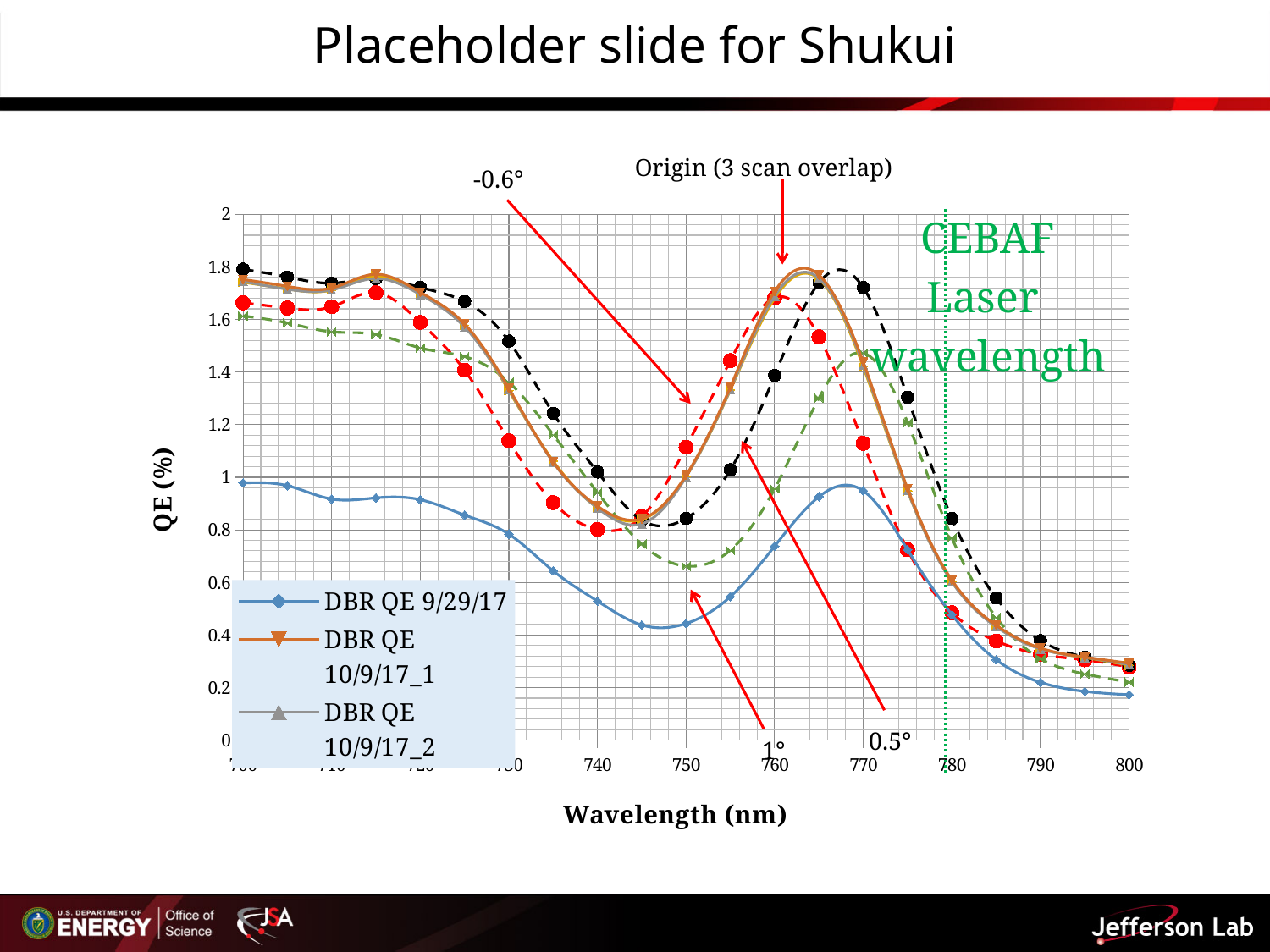
What is the y-axis title of the chart? QE (%) Is the value of DBR QE 10/9/17_1 at 800 nm greater or less than 0.4? less What is the x-axis title of the chart? Wavelength (nm) Is the value of DBR QE 9/29/17 at 800 nm greater or less than 0.2? less Does the DBR QE 9/29/17 series rise or fall between 780 nm and 800 nm? fall How many series does the visible legend list? 3 Is the value of DBR QE 9/29/17 at 700 nm greater or less than 0.8? greater What kind of chart is shown on the slide? line chart Which of the legend series has the lowest QE values across the wavelength range? DBR QE 9/29/17 At 700 nm, which series has the larger value: DBR QE 9/29/17 or DBR QE 10/9/17_1? DBR QE 10/9/17_1